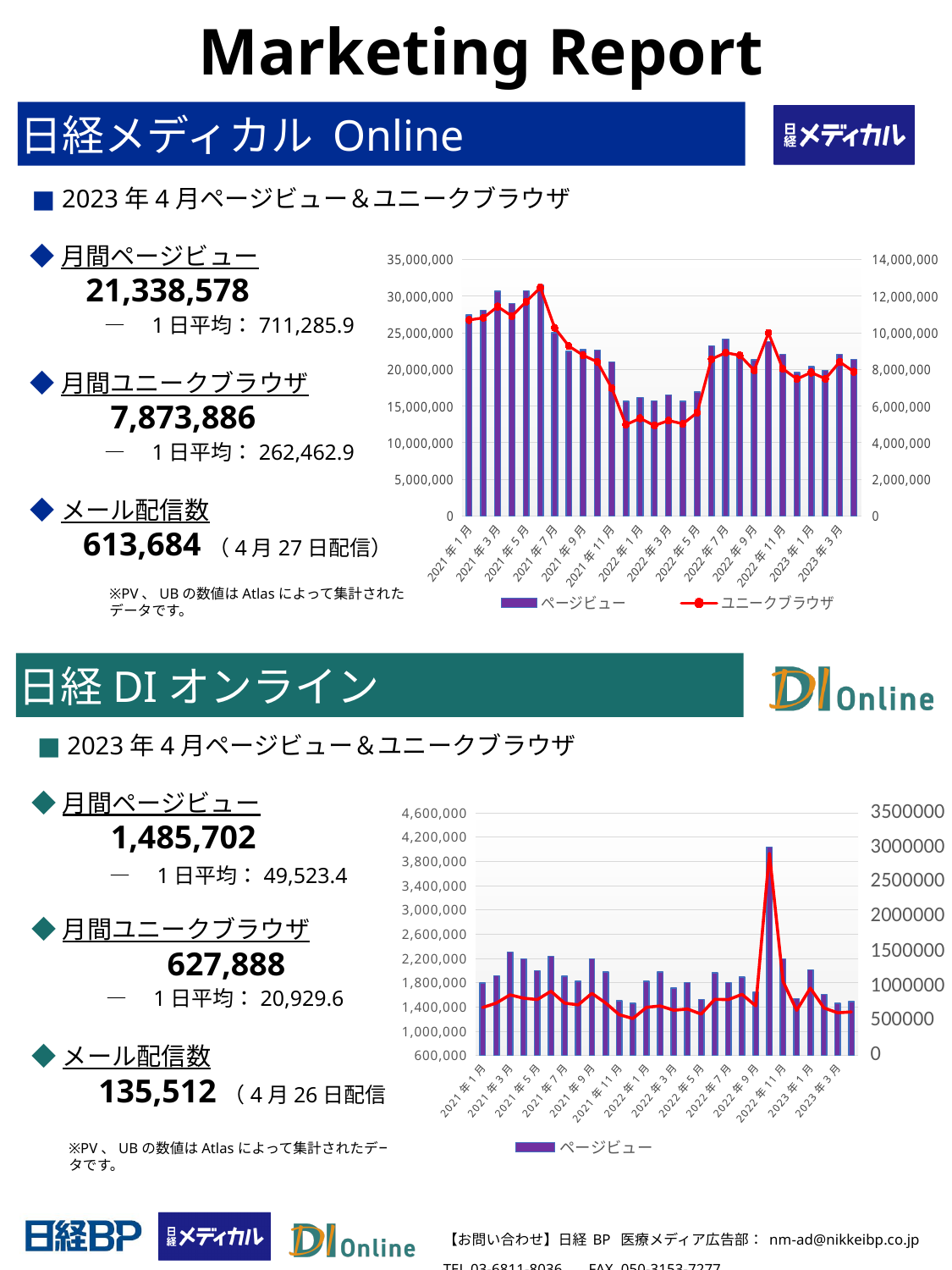
In the bottom chart (日経DIオンライン), in which year does the tallest ページビュー bar occur? 2022 How many series does the legend of the bottom chart (日経DIオンライン) list? 1 In the top chart (日経メディカル Online), which series is drawn as a red line? ユニークブラウザ How many series does the legend of the top chart (日経メディカル Online) list? 2 In the top chart (日経メディカル Online), do the ページビュー bars rise or fall from 2021年7月 to 2022年1月? fall In the top chart (日経メディカル Online), is the ページビュー value for 2022年1月 greater or less than 20,000,000? less In the bottom chart (日経DIオンライン), is the tallest ページビュー bar greater or less than 3,400,000? greater In the top chart (日経メディカル Online), is the ページビュー value for 2021年1月 greater or less than 25,000,000? greater What kind of chart is the 日経メディカル Online chart (top chart)? Combined bar and line chart What is the maximum value shown on the left axis of the top chart (日経メディカル Online)? 35,000,000